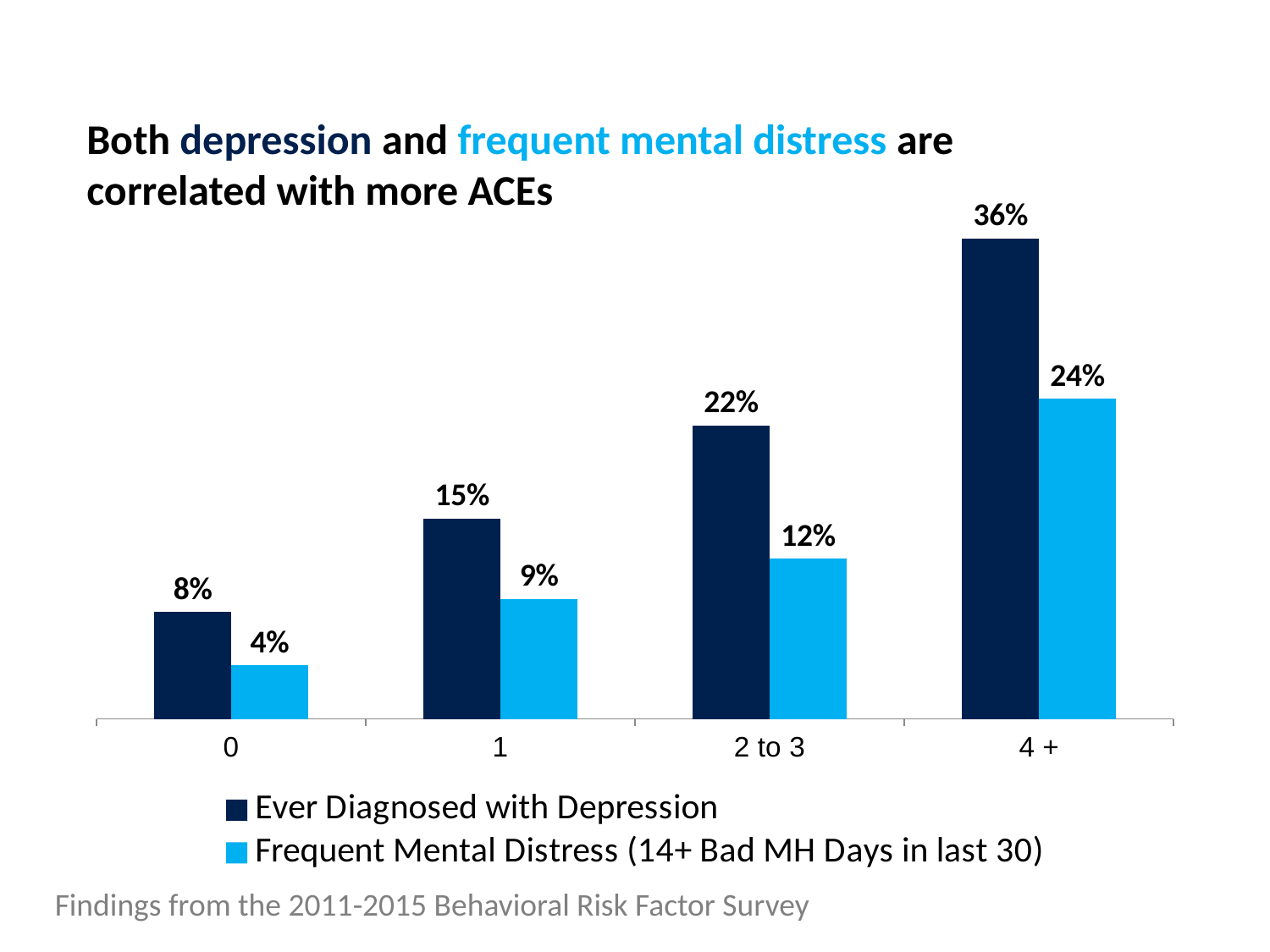
What percentage of people with 4 + ACEs were ever diagnosed with depression? 36% How many series does the legend list? 2 What is the difference between the Ever Diagnosed with Depression and Frequent Mental Distress values for the 4 + category? 12% Do the Ever Diagnosed with Depression values rise or fall as the number of ACEs increases? Rise What is the Frequent Mental Distress value for the 0 ACEs category? 4% Which is larger: the Frequent Mental Distress value for 2 to 3 ACEs or the Ever Diagnosed with Depression value for 1 ACE? Ever Diagnosed with Depression value for 1 ACE Which ACE category has the lowest Frequent Mental Distress value? 0 What is the Frequent Mental Distress value for the 1 ACE category? 9% What is the Ever Diagnosed with Depression value for the 2 to 3 ACEs category? 22% What kind of chart is shown on the slide? Bar chart Which ACE category has the highest Ever Diagnosed with Depression value? 4 + How many ACE categories are shown on the x axis? 4